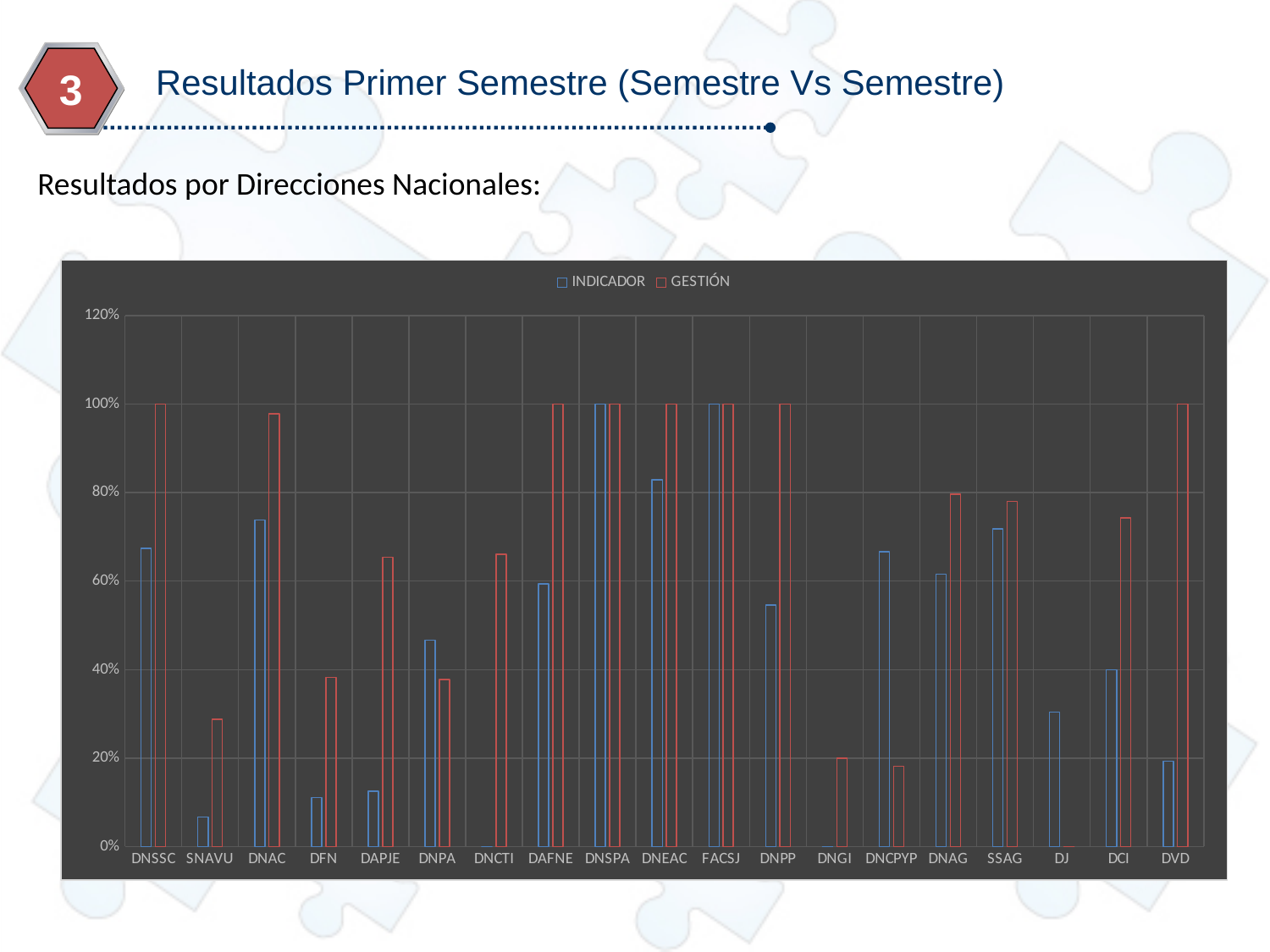
Is the GESTIÓN value for SNAVU greater or less than 40%? less Is the GESTIÓN value for DAPJE greater or less than 60%? greater What kind of chart is shown on the slide? bar chart For DNAC, which is larger: the INDICADOR value or the GESTIÓN value? GESTIÓN For DNSSC, which is larger: the INDICADOR value or the GESTIÓN value? GESTIÓN Is the INDICADOR value for DVD greater or less than 40%? less Which category has the highest INDICADOR value? DNSPA and FACSJ (both 100%) For DNCPYP, which is larger: the INDICADOR value or the GESTIÓN value? INDICADOR How many categories are shown along the x axis of the chart? 19 How many series does the chart legend list? 2 What are the two series names listed in the chart legend? INDICADOR and GESTIÓN